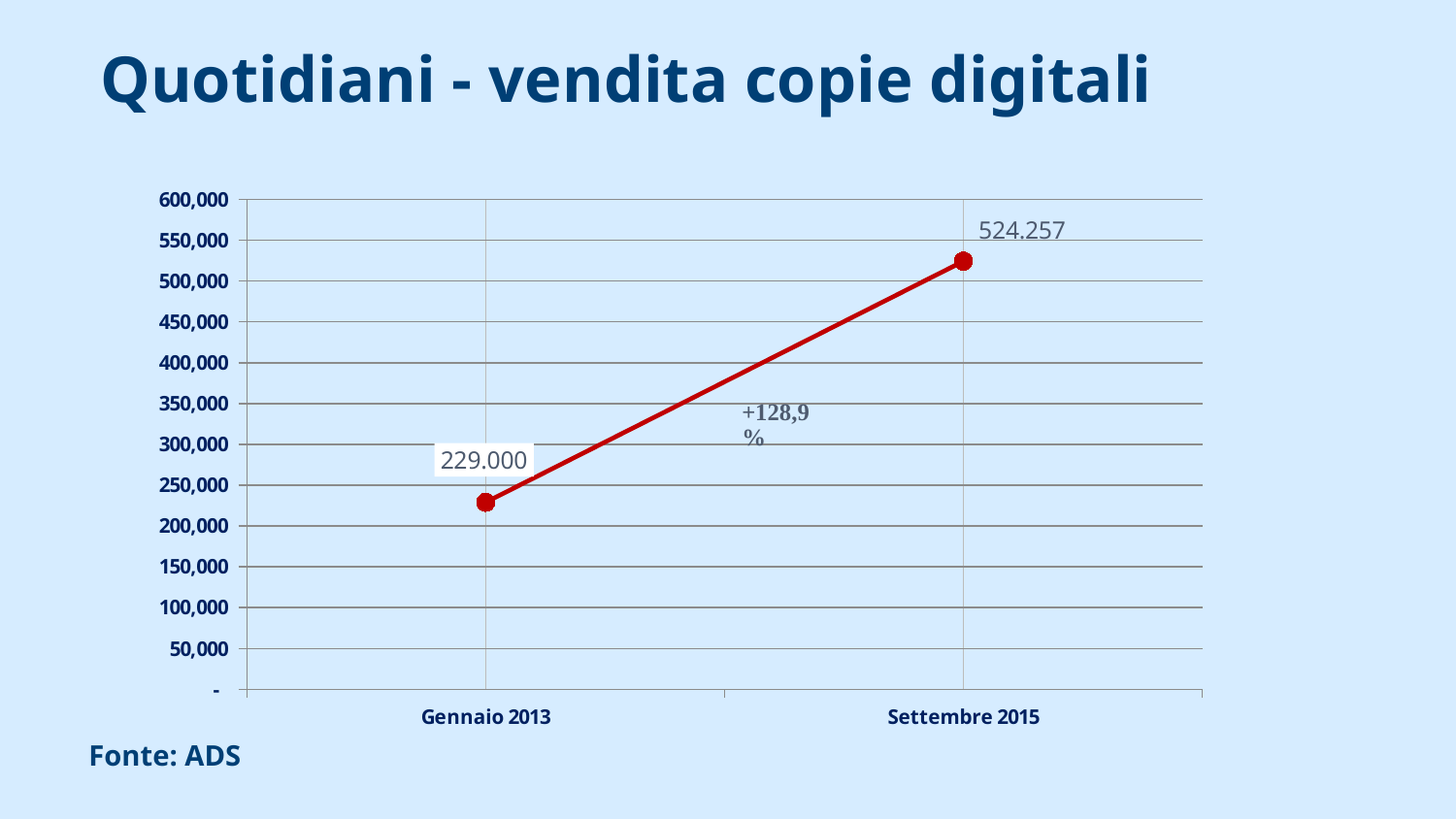
Which is larger, the value for Gennaio 2013 or the value for Settembre 2015? Settembre 2015 What is the value for Gennaio 2013? 229.000 Do the values rise or fall from Gennaio 2013 to Settembre 2015? rise Which point has the highest value? Settembre 2015 Is the value for Gennaio 2013 greater or less than 250,000? less How many data points are plotted on the chart? 2 Which point has the lowest value? Gennaio 2013 What percentage change is annotated on the chart between the two points? +128,9 % Is the value for Settembre 2015 greater or less than 500,000? greater What is the value for Settembre 2015? 524.257 What kind of chart is shown on the slide? line chart What is the difference between the value for Settembre 2015 and the value for Gennaio 2013? 295.257